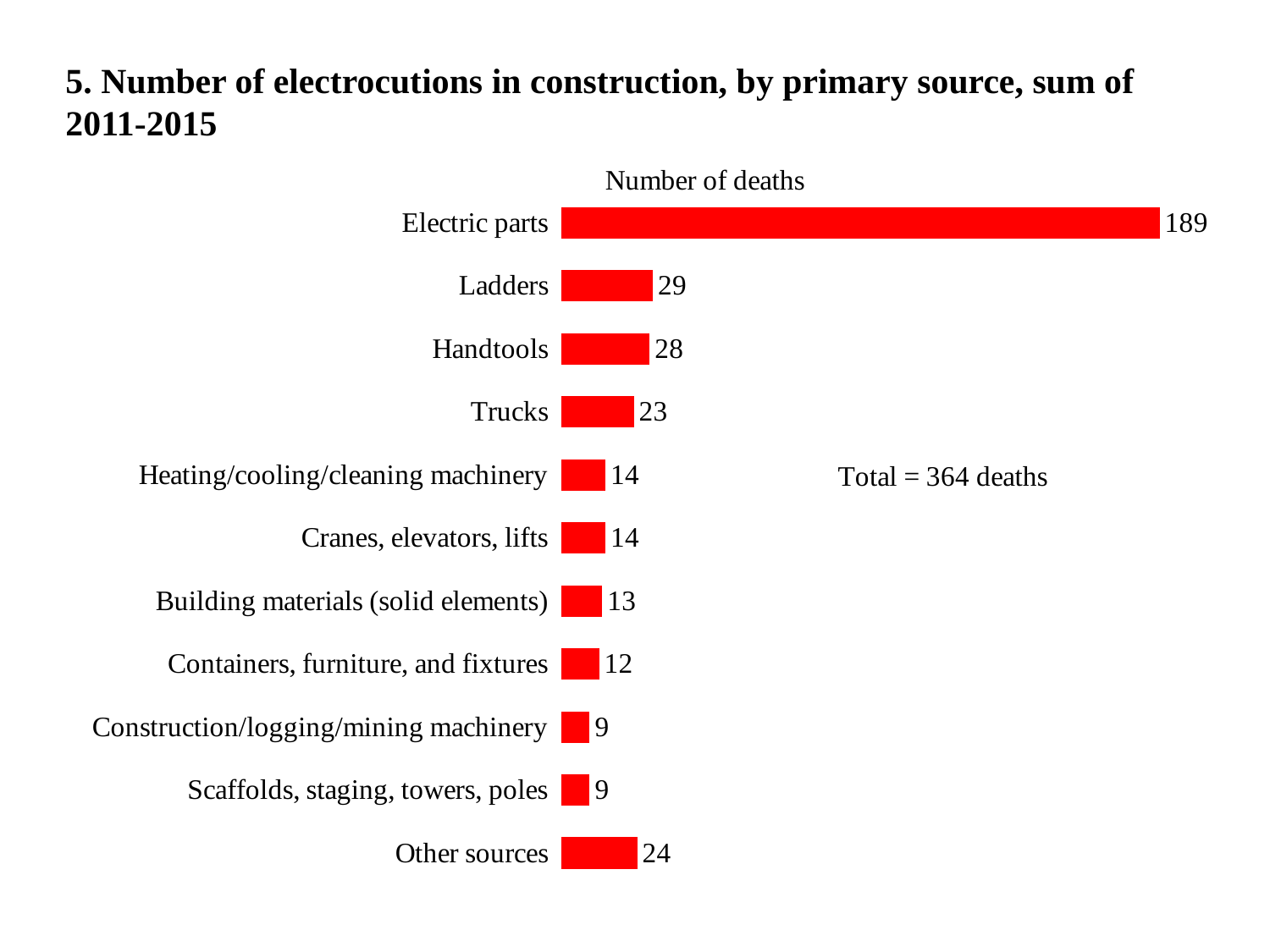
What is the difference in deaths between Electric parts and Ladders? 160 How many primary source categories are shown in the chart? 11 What total number of deaths is stated on the slide? 364 deaths What is the number of deaths for Ladders? 29 What type of chart is shown on the slide? Bar chart How many deaths are attributed to Electric parts? 189 What is the number of deaths for Other sources? 24 Which has more deaths, Other sources or Building materials (solid elements)? Other sources Which has more deaths, Handtools or Trucks? Handtools What is the difference in deaths between Trucks and Containers, furniture, and fixtures? 11 Which primary source has the highest number of deaths? Electric parts What is the title of the chart's value axis label shown above the bars? Number of deaths